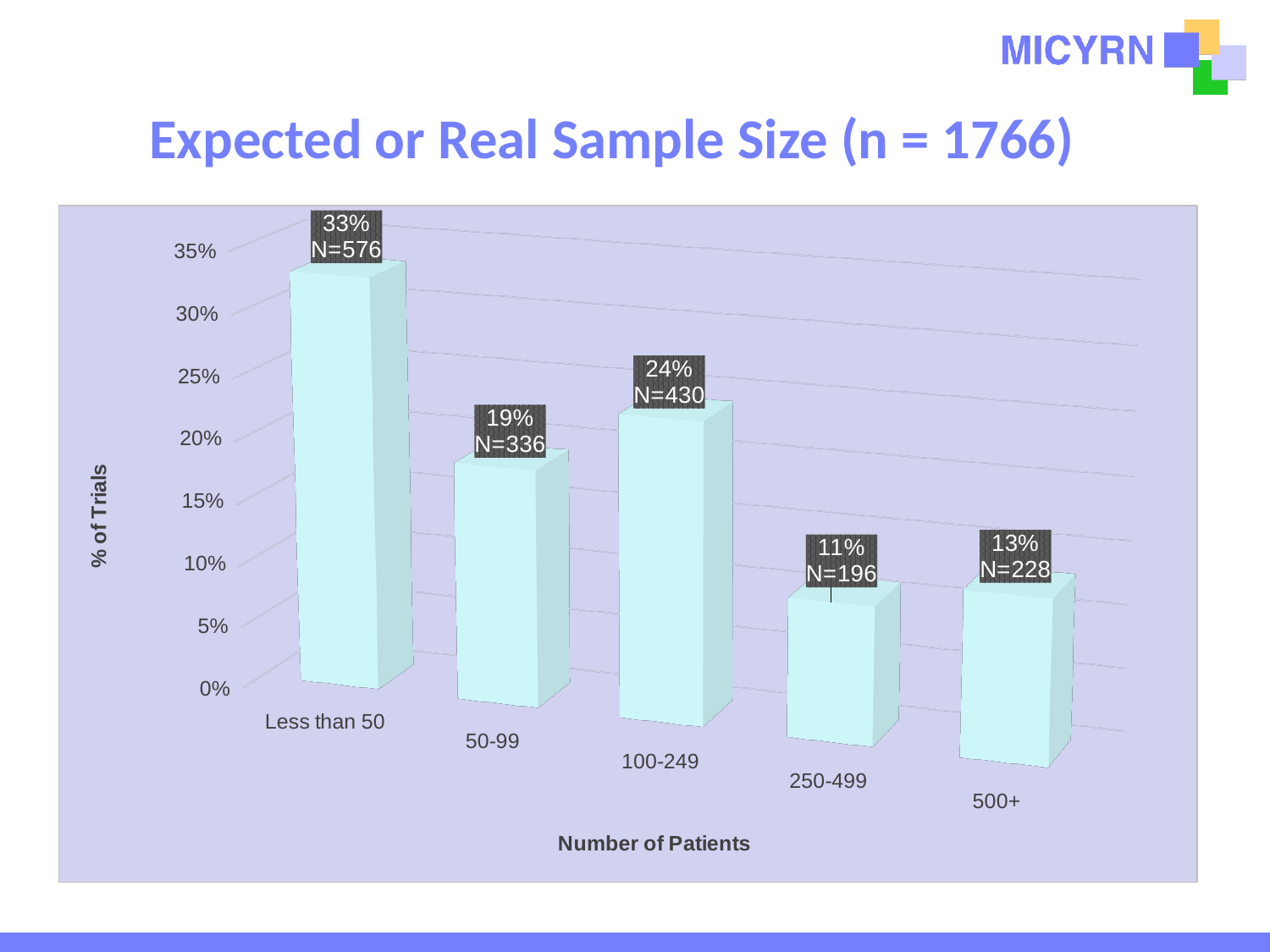
Which sample size category has the lowest percentage of trials? 250-499 What percentage of trials had a sample size of less than 50 patients? 33% Which category has a larger percentage of trials, 100-249 or 500+? 100-249 What is the N value shown for the 500+ patients category? N=228 What is the N value shown for the 100-249 patients category? N=430 What is the difference in percentage points between the 'Less than 50' and '50-99' categories? 14 What is the label of the x axis? Number of Patients What percentage of trials had a sample size of 250-499 patients? 11% What is the title of the chart? Expected or Real Sample Size (n = 1766) What type of chart is shown on the slide? Bar chart How many sample size categories are shown on the x axis? 5 Which sample size category has the highest percentage of trials? Less than 50